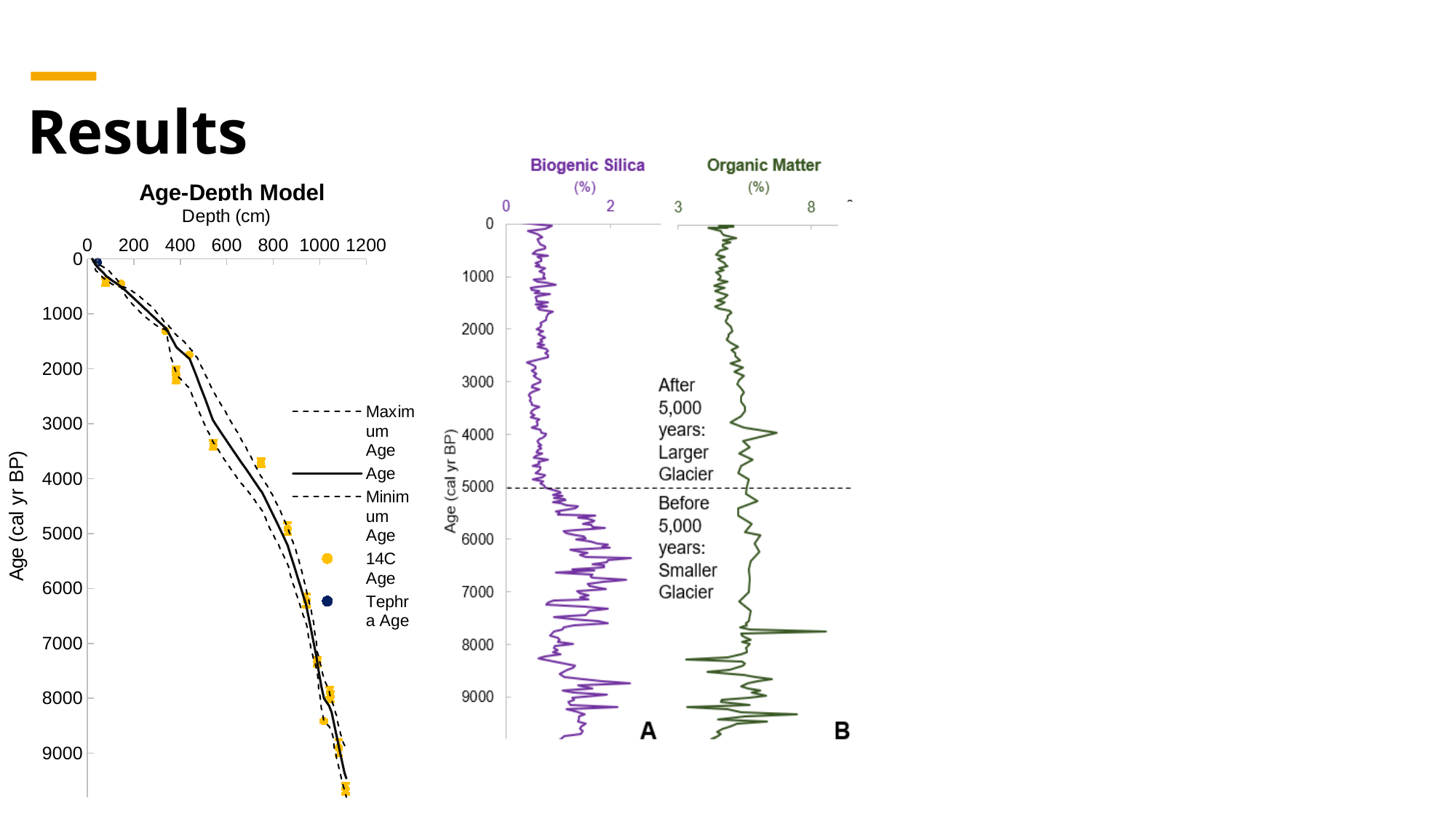
In the Age-Depth Model chart, what is the label of the horizontal axis? Depth (cm) What is the title of the chart on the left of the slide? Age-Depth Model In panel A (Biogenic Silica), is the biogenic silica value at 3000 cal yr BP greater or less than 2%? less What kind of chart is the Age-Depth Model? line chart In the Age-Depth Model chart, is the depth of the Age line at 9000 cal yr BP greater or less than 1000 cm? greater In panel B (Organic Matter), is the organic matter value at 1000 cal yr BP greater or less than 8%? less In the Age-Depth Model chart, how many entries does the legend list? 5 In the Age-Depth Model chart, does age rise or fall as depth increases? rise In panel A (Biogenic Silica), is biogenic silica generally higher before or after 5,000 years BP? before